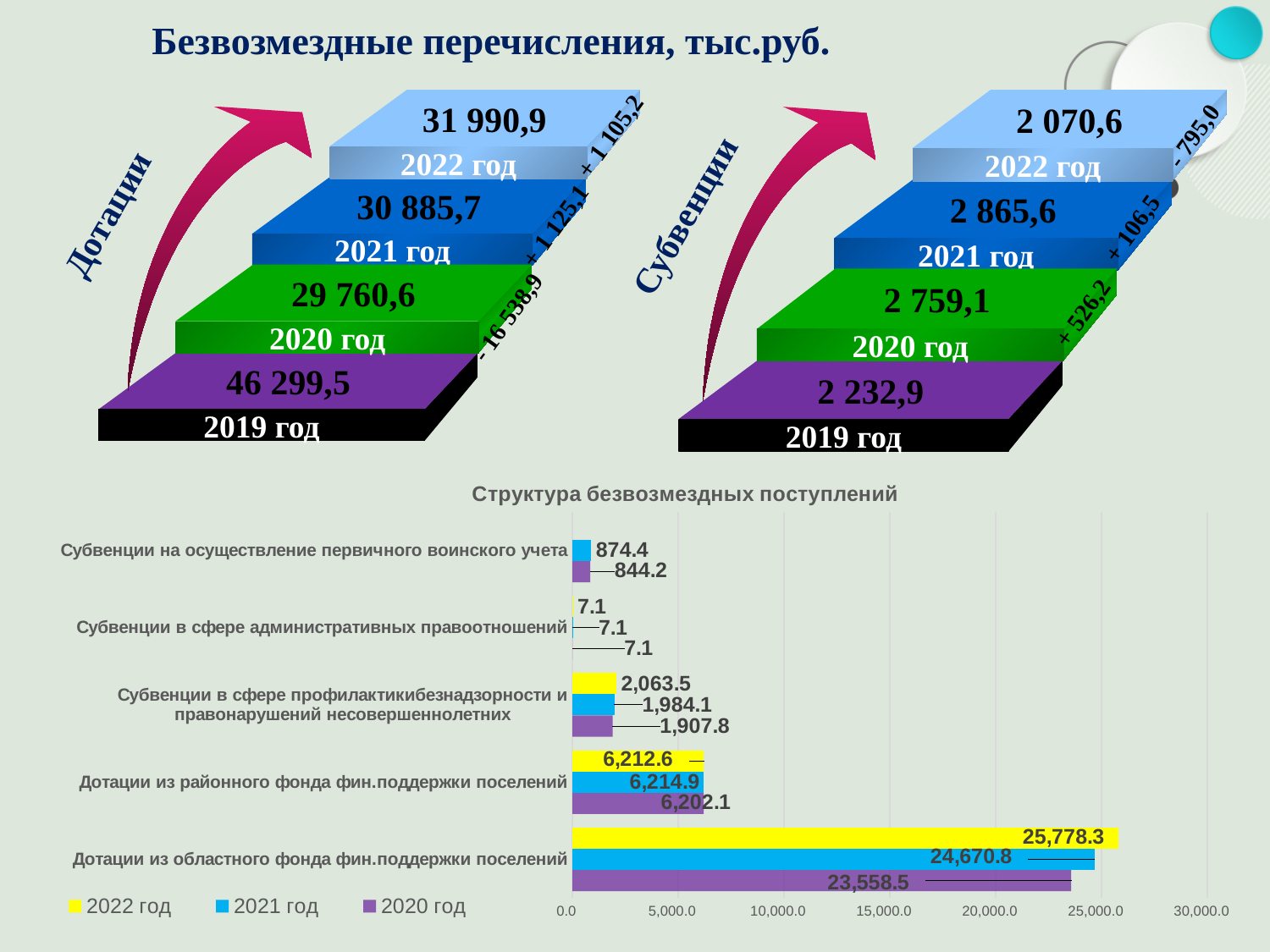
On the Субвенции chart (top right), what is the value for 2021 год? 2 865,6 On the Субвенции chart (top right), which year has the highest value? 2021 год What kind of chart is the Структура безвозмездных поступлений chart? bar chart On the Структура безвозмездных поступлений chart, what is the difference between the 2022 год and 2020 год values for Дотации из областного фонда фин.поддержки поселений? 2,219.8 On the Структура безвозмездных поступлений chart, what is the 2022 год value for Дотации из областного фонда фин.поддержки поселений? 25,778.3 On the Дотации chart (top left), what is the difference between the 2022 год and 2021 год values? 1 105,2 On the Структура безвозмездных поступлений chart, for Субвенции в сфере профилактики безнадзорности и правонарушений несовершеннолетних, which is larger: the 2022 год value or the 2020 год value? 2022 год On the Структура безвозмездных поступлений chart, which category has the highest 2021 год value? Дотации из областного фонда фин.поддержки поселений How many categories are shown on the Структура безвозмездных поступлений chart? 5 How many series does the legend of the Структура безвозмездных поступлений chart list? 3 On the Дотации chart (top left), which year has the lowest value? 2020 год On the Дотации chart (top left), what is the value for 2019 год? 46 299,5